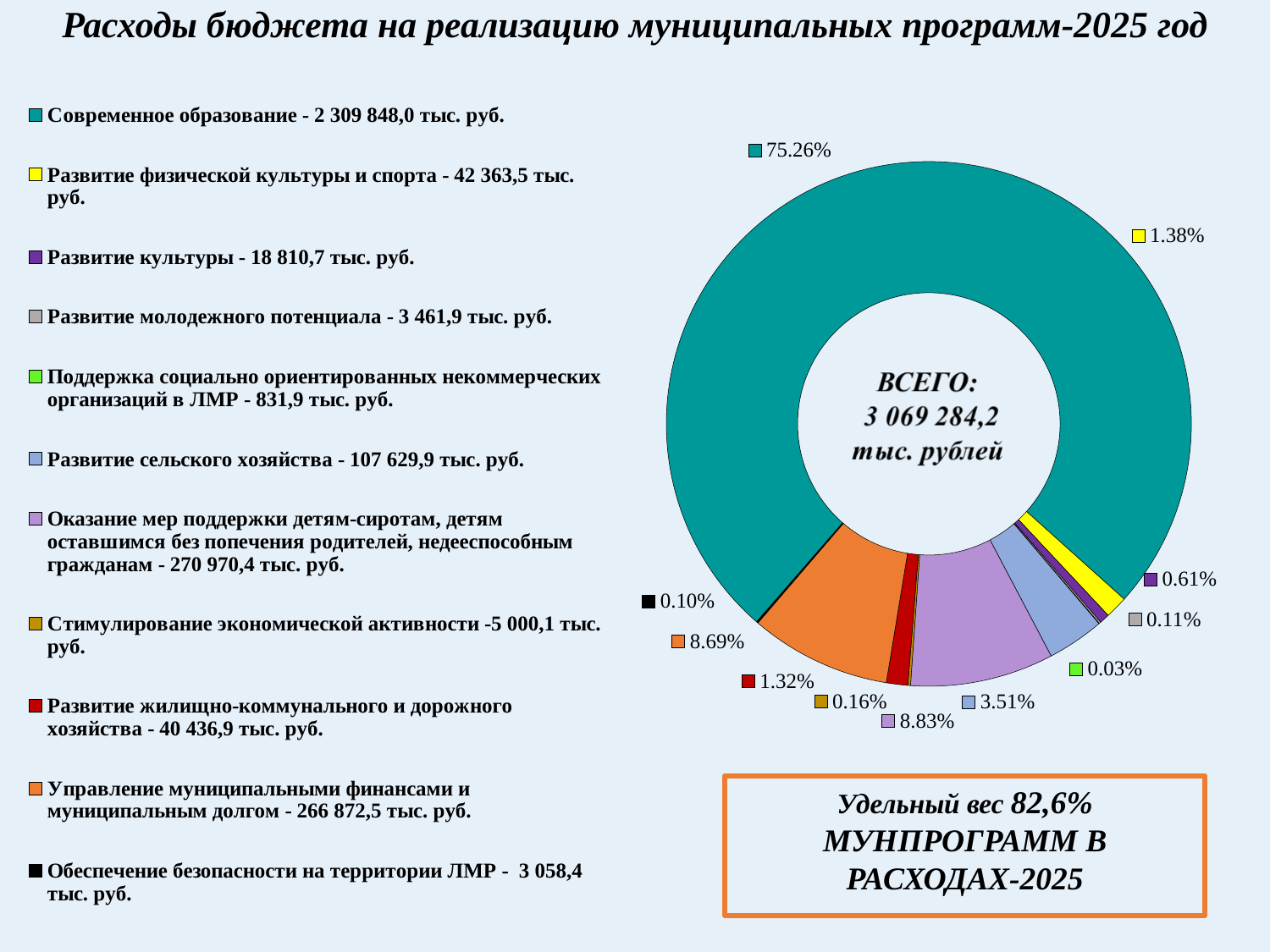
Which program has the smallest share of the budget expenditures? Поддержка социально ориентированных некоммерческих организаций в ЛМР Which has a larger share: Оказание мер поддержки детям-сиротам (8.83%) or Управление муниципальными финансами (8.69%)? Оказание мер поддержки детям-сиротам What is the difference in percentage points between the share for Развитие физической культуры и спорта (1.38%) and Развитие жилищно-коммунального и дорожного хозяйства (1.32%)? 0.06% What is the expenditure amount for Развитие культуры according to the legend? 18 810,7 тыс. руб. What is the title of the slide? Расходы бюджета на реализацию муниципальных программ-2025 год What is the total expenditure shown in the centre of the chart? 3 069 284,2 тыс. рублей Which program has the largest share of the budget expenditures? Современное образование What share of expenditures does Развитие сельского хозяйства account for? 3.51% How many categories (programs) does the legend list? 11 What kind of chart is shown on the slide? doughnut (pie) chart What is the expenditure amount for Управление муниципальными финансами и муниципальным долгом? 266 872,5 тыс. руб. What share of expenditures does Современное образование account for? 75.26%